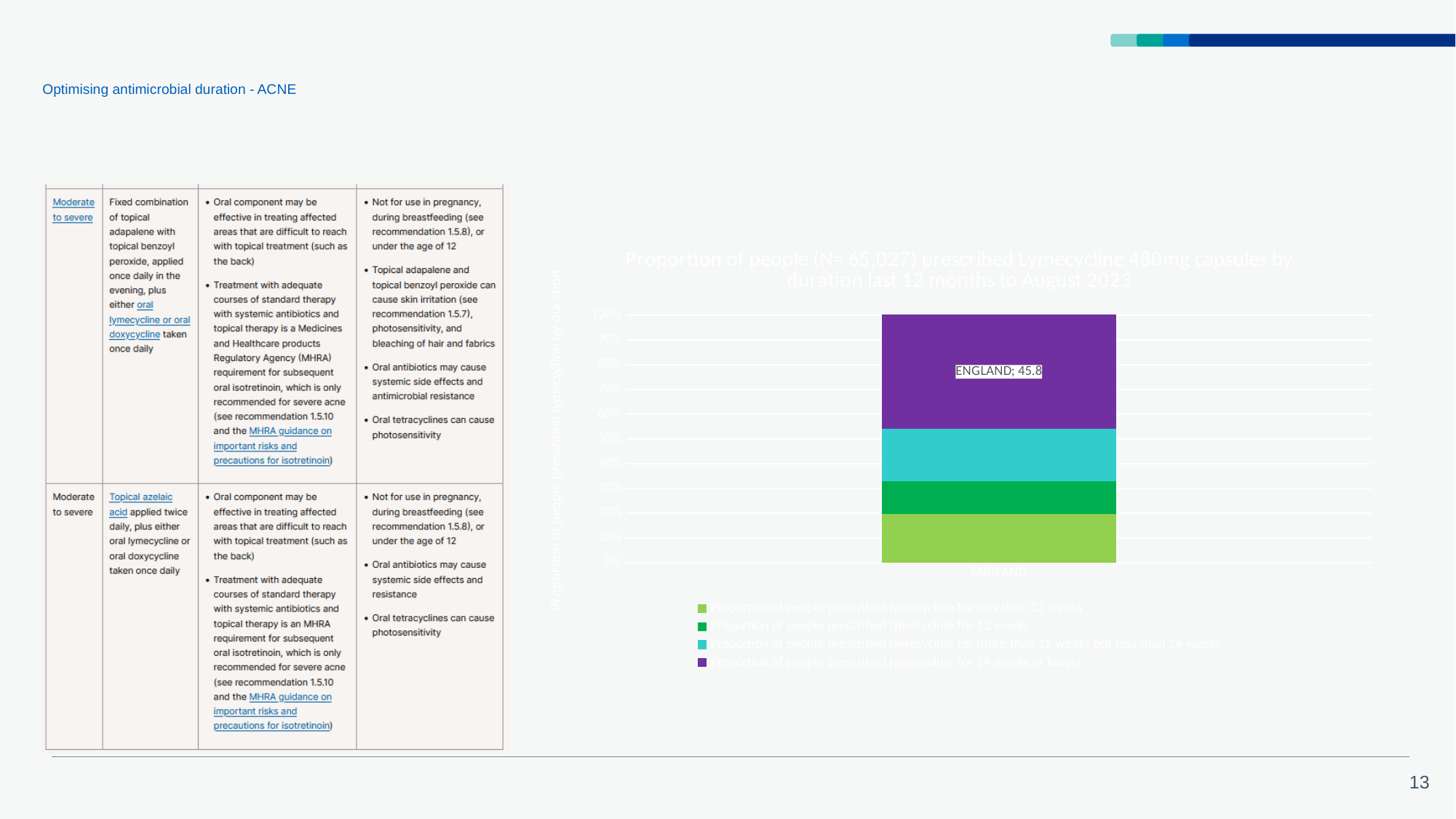
What is the category label shown on the x axis of the chart? ENGLAND What value is printed on the data label inside the purple segment of the ENGLAND bar? 45.8 Is the size of the light blue segment of the ENGLAND bar greater or less than 10%? greater How many categories are shown on the x axis of the chart? 1 What kind of chart is shown on the slide? Stacked bar chart Is the size of the light green (bottom) segment of the ENGLAND bar greater or less than 30%? less Is the size of the light green (bottom) segment of the ENGLAND bar greater or less than 10%? greater How many series does the chart's legend list? 4 Which coloured segment of the ENGLAND bar is the largest? Purple Which is larger in the ENGLAND bar, the purple segment or the light blue segment? Purple Which coloured segment of the ENGLAND bar is the smallest? Dark green